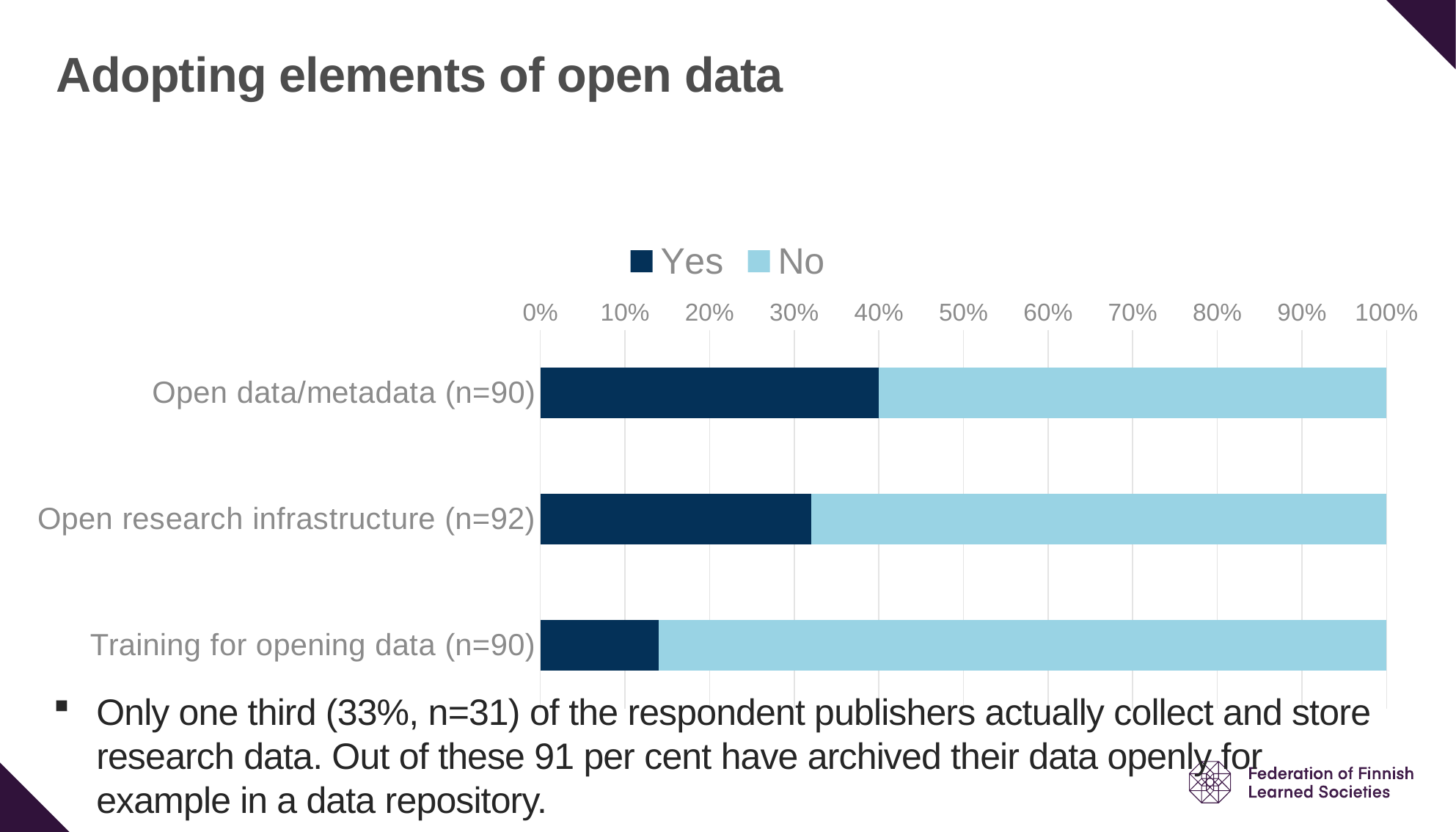
Is the 'Yes' value for Open research infrastructure (n=92) greater or less than 40%? less Which category has the smallest 'Yes' share? Training for opening data (n=90) What kind of chart is shown on the slide? bar chart Which has a larger 'Yes' share: Open data/metadata (n=90) or Open research infrastructure (n=92)? Open data/metadata (n=90) Is the 'No' share for Training for opening data (n=90) greater or less than 80%? greater What are the two entries in the chart legend? Yes, No Is the 'Yes' value for Open research infrastructure (n=92) greater or less than 30%? greater How many series does the legend list? 2 What is the title of the slide containing the chart? Adopting elements of open data How many categories are plotted on the chart? 3 Which category has the largest 'Yes' share? Open data/metadata (n=90)